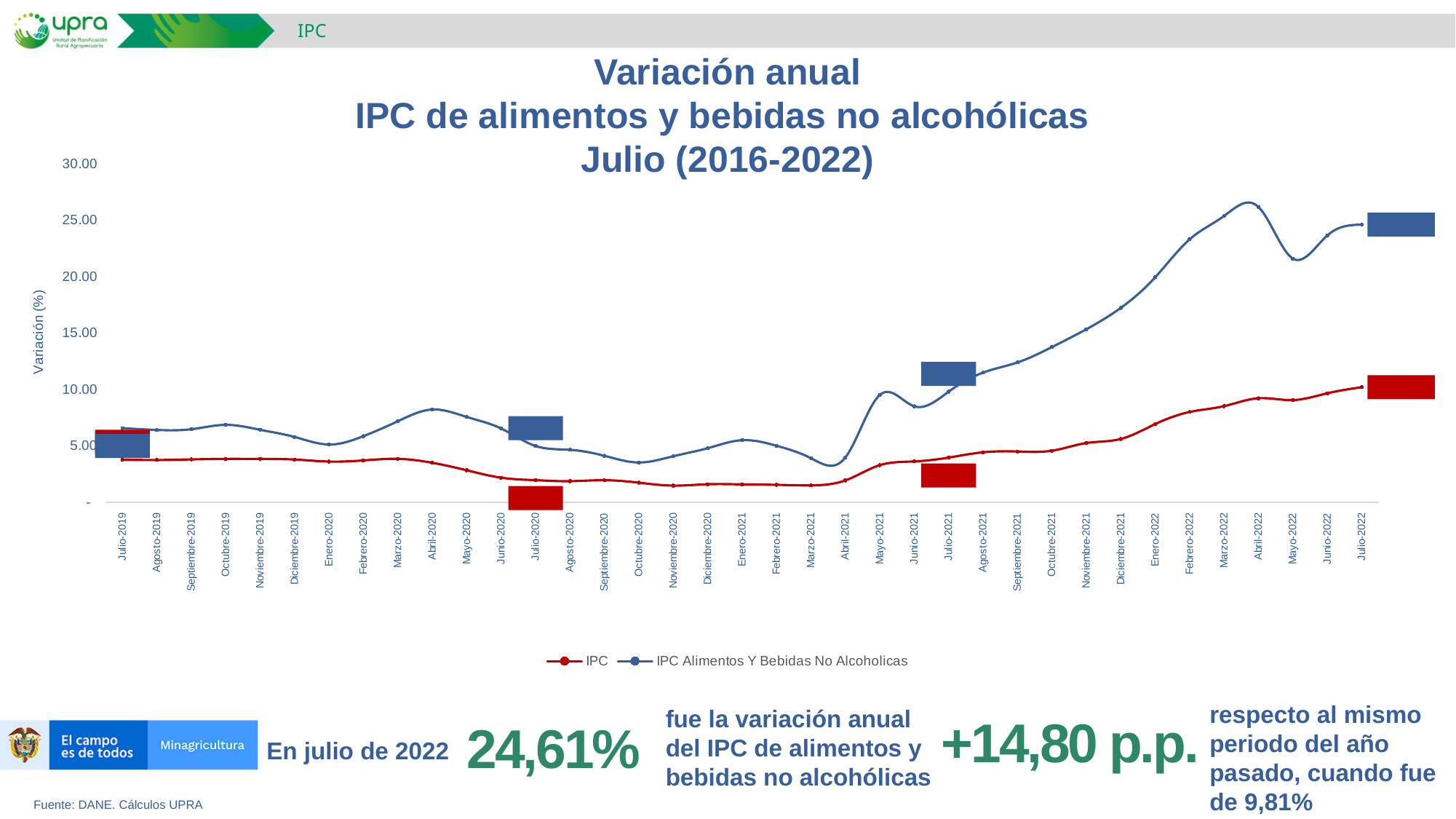
Is the value of IPC Alimentos Y Bebidas No Alcoholicas in Abril-2022 greater or less than 25.00? greater According to the slide, what was the annual variation of the IPC de alimentos y bebidas no alcohólicas in Julio-2021? 9,81% According to the slide, what was the annual variation of the IPC de alimentos y bebidas no alcohólicas in Julio-2022? 24,61% What are the two series named in the legend? IPC and IPC Alimentos Y Bebidas No Alcoholicas How many monthly points are plotted along the x axis, from Julio-2019 to Julio-2022? 37 What is the label of the vertical axis? Variación (%) Is the value of IPC Alimentos Y Bebidas No Alcoholicas in Abril-2021 greater or less than 5.00? less Does the IPC series rise or fall between Julio-2021 and Julio-2022? Rise In Julio-2022, which series has the larger value, IPC or IPC Alimentos Y Bebidas No Alcoholicas? IPC Alimentos Y Bebidas No Alcoholicas What kind of chart is shown on the slide? Line chart How many series does the legend list? 2 In which month does the IPC Alimentos Y Bebidas No Alcoholicas series reach its highest value? Abril-2022